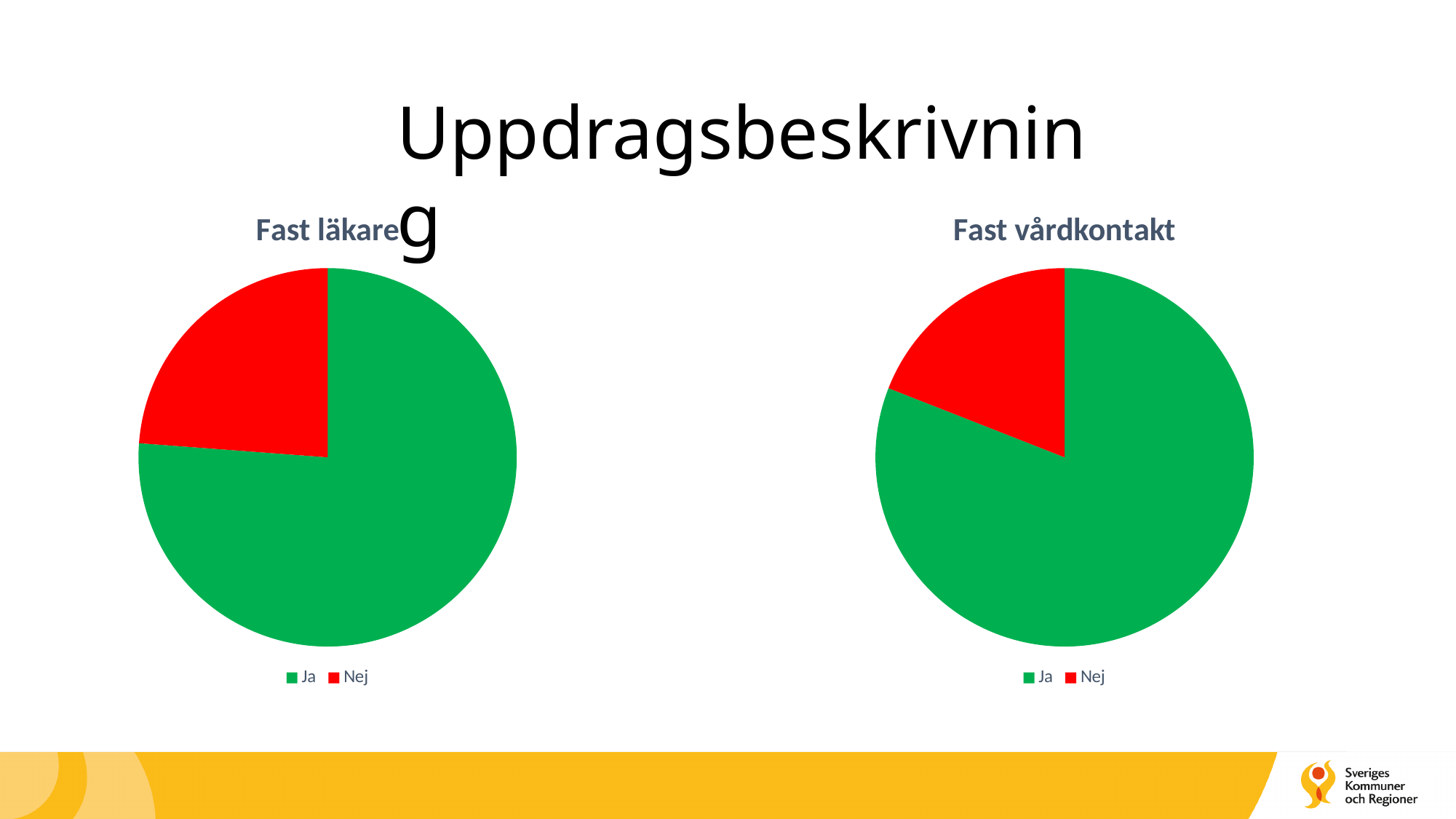
How many slices does the "Fast läkare" pie chart have? 2 In the "Fast vårdkontakt" chart, which slice is the largest? Ja In the "Fast vårdkontakt" chart, which slice is the smallest? Nej How many entries does the legend of the "Fast vårdkontakt" chart list? 2 In the "Fast läkare" chart, which is larger, Ja or Nej? Ja What is the title of the pie chart on the right of the slide? Fast vårdkontakt In the "Fast vårdkontakt" chart, which is larger, Ja or Nej? Ja In the "Fast läkare" chart, what colour is the Nej slice? red What kind of chart is the "Fast vårdkontakt" chart? pie chart In the "Fast läkare" chart, which slice is the smallest? Nej What kind of chart is the "Fast läkare" chart? pie chart In the "Fast läkare" chart, which slice is the largest? Ja